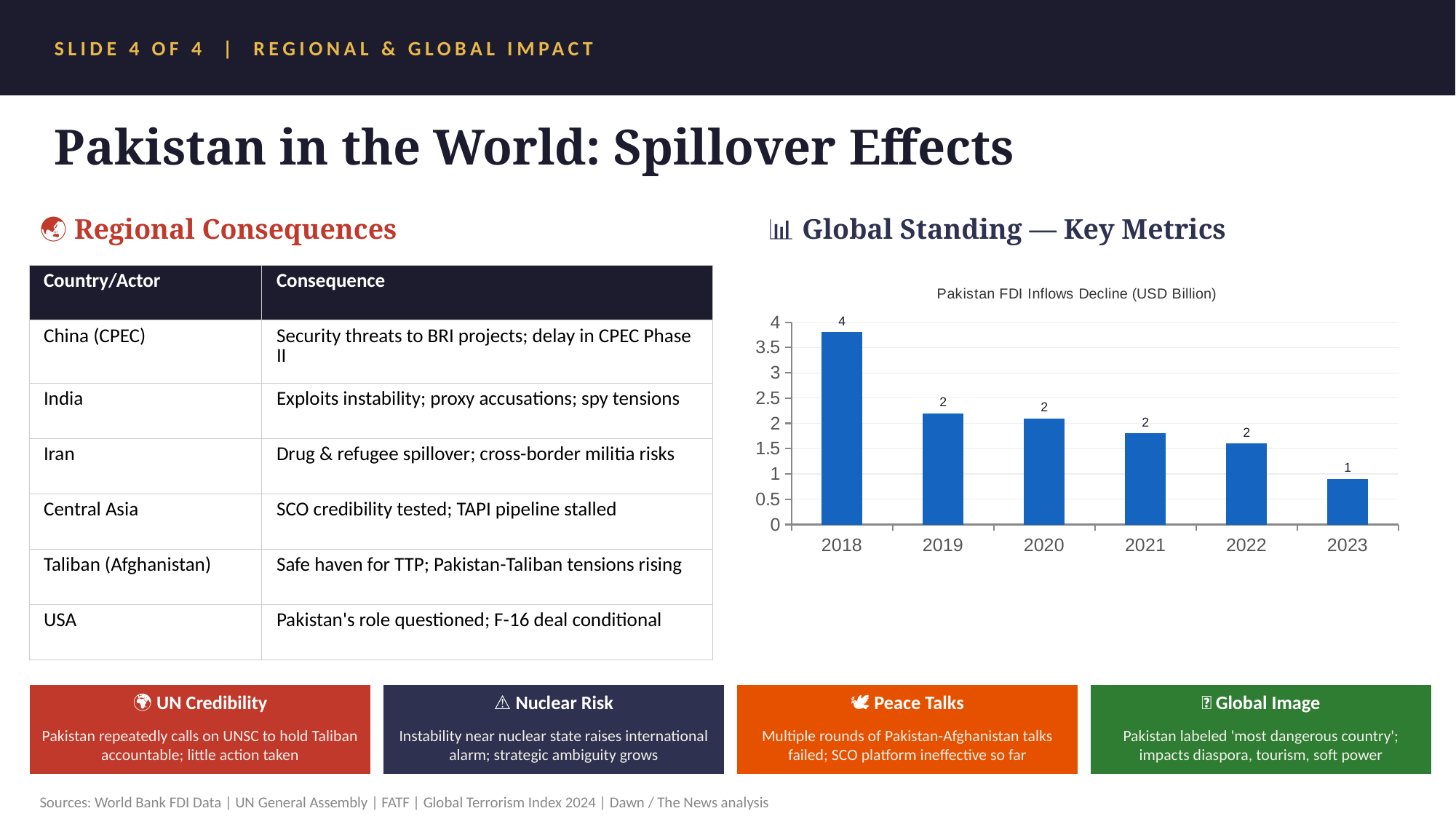
Is the FDI inflow value for 2018 greater or less than 3? greater Which year has the highest FDI inflow in the chart? 2018 Is the FDI inflow value for 2023 greater or less than 1.5? less How many years are plotted in the Pakistan FDI Inflows Decline chart? 6 Do FDI inflows rise or fall from 2018 to 2023 in the chart? Fall Which year has the larger FDI inflow, 2019 or 2022? 2019 What value is labelled on the 2023 bar in the FDI chart? 1 What is the title of the chart on the slide? Pakistan FDI Inflows Decline (USD Billion) What kind of chart is shown under Global Standing — Key Metrics? Bar chart What value is labelled on the 2018 bar in the FDI chart? 4 Which year has the lowest FDI inflow in the chart? 2023